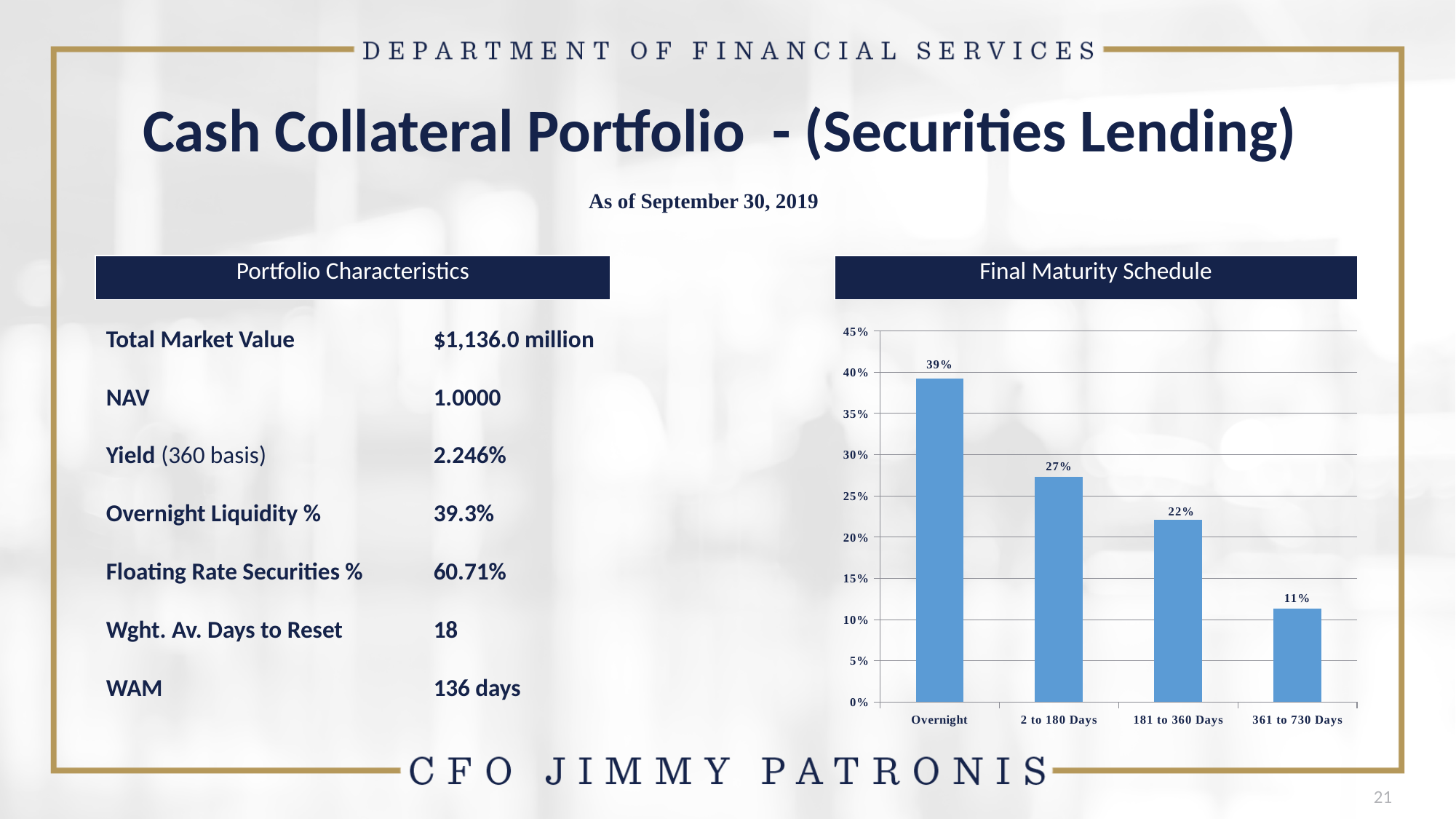
Which maturity bucket has the highest value in the Final Maturity Schedule chart? Overnight What is the value for 181 to 360 Days in the Final Maturity Schedule chart? 22% Which maturity bucket has the lowest value in the Final Maturity Schedule chart? 361 to 730 Days What is the difference between the Overnight and 2 to 180 Days values in the Final Maturity Schedule chart? 12% Which is larger in the Final Maturity Schedule chart: 181 to 360 Days or 361 to 730 Days? 181 to 360 Days What is the value for 361 to 730 Days in the Final Maturity Schedule chart? 11% What is the value for 2 to 180 Days in the Final Maturity Schedule chart? 27% Do the values in the Final Maturity Schedule chart rise or fall from Overnight to 361 to 730 Days? Fall Is the value for 2 to 180 Days in the Final Maturity Schedule chart greater or less than 25%? greater What kind of chart is the Final Maturity Schedule? Bar chart What is the value for Overnight in the Final Maturity Schedule chart? 39% How many maturity buckets are shown in the Final Maturity Schedule chart? 4